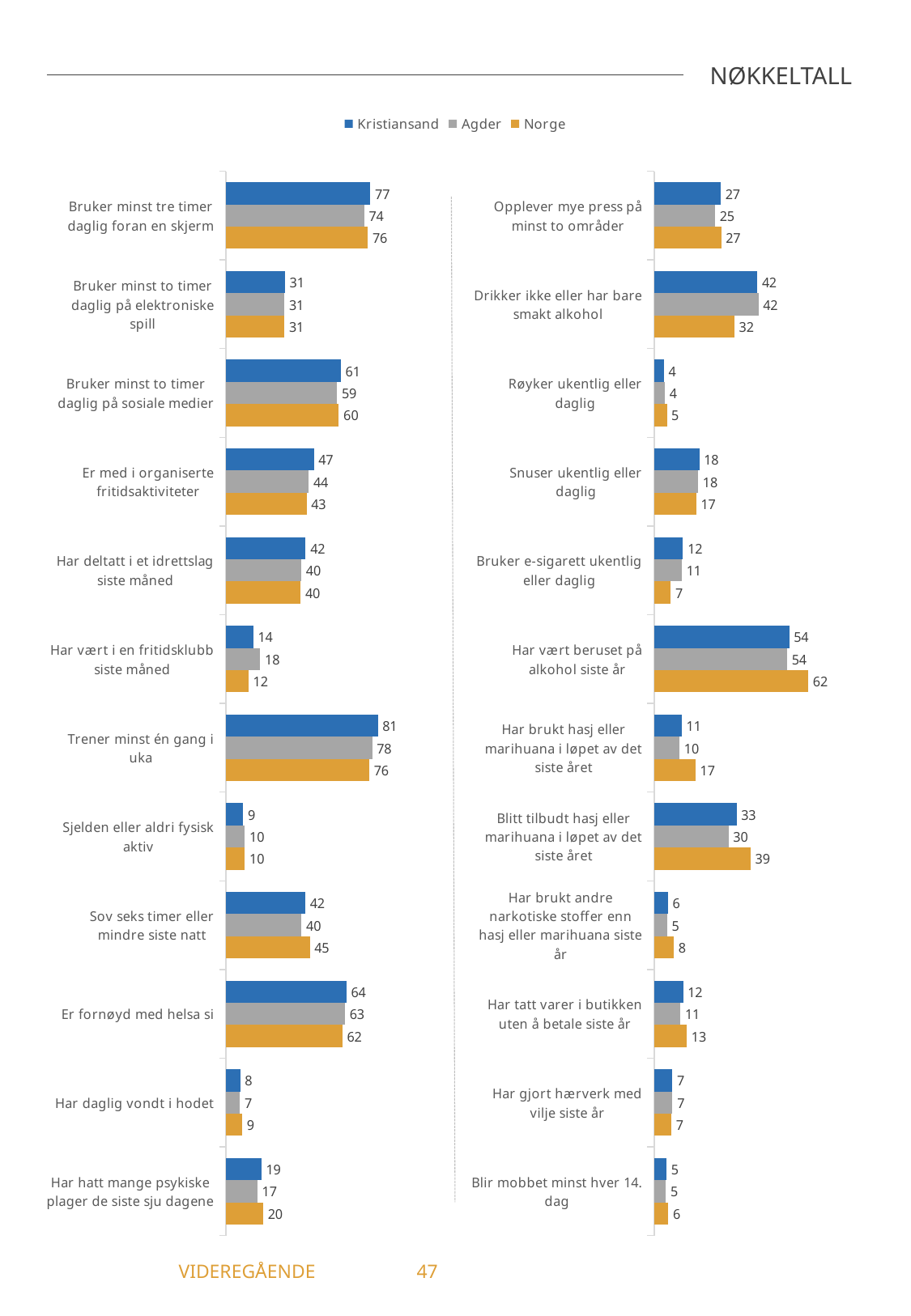
What kind of chart is used on this slide? Bar chart How many series does the legend list? 3 In the right chart, which category has the lowest Kristiansand value? Røyker ukentlig eller daglig Which colour represents Norge in the legend? Orange In the left chart, what is the Agder value for "Har vært i en fritidsklubb siste måned"? 18 In the left chart, which is larger for "Sov seks timer eller mindre siste natt": the Kristiansand value or the Norge value? Norge How many categories are shown in the left chart? 12 In the right chart, what is the difference between the Norge and Kristiansand values for "Drikker ikke eller har bare smakt alkohol"? 10 In the left chart, what is the Kristiansand value for "Bruker minst tre timer daglig foran en skjerm"? 77 In the left chart, which category has the highest Kristiansand value? Trener minst én gang i uka In the right chart, what is the Norge value for "Har vært beruset på alkohol siste år"? 62 In the right chart, what is the difference between the Norge and Agder values for "Blitt tilbudt hasj eller marihuana i løpet av det siste året"? 9